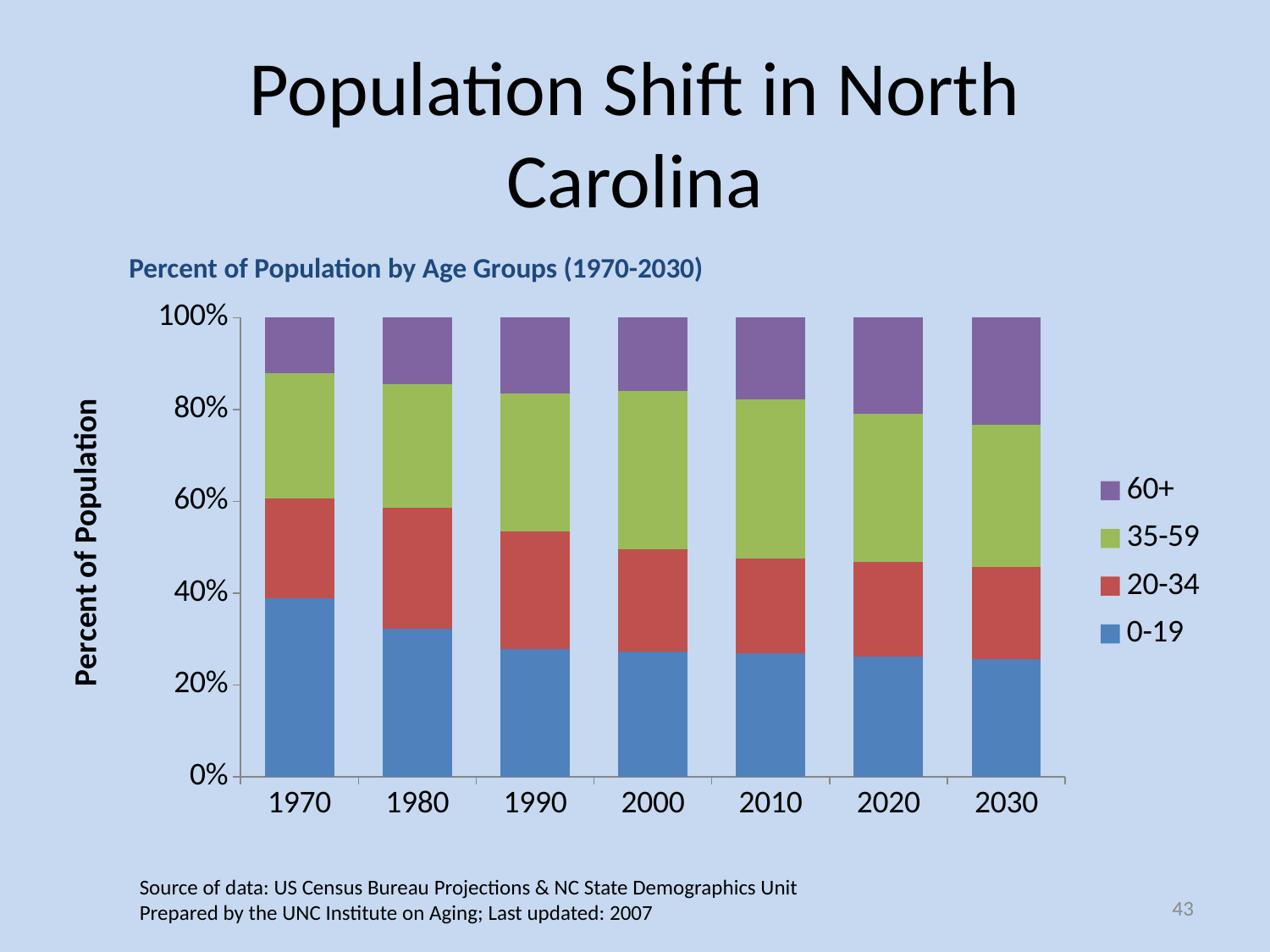
What is the label on the vertical axis of the chart? Percent of Population Is the share of the 0-19 age group in 2030 greater or less than 40%? less How many age groups does the legend list? 4 What kind of chart is shown on the slide? Stacked bar chart Does the share of the 0-19 age group rise or fall from 1970 to 2030? fall How many years are shown along the x axis of the chart? 7 Which year has the larger share for the 0-19 age group, 1970 or 2030? 1970 Is the share of the 0-19 age group in 1970 greater or less than 20%? greater What is the title of the chart? Percent of Population by Age Groups (1970-2030) Does the share of the 60+ age group rise or fall from 1970 to 2030? rise Which year has the larger share for the 60+ age group, 1970 or 2030? 2030 What is the total height of the stacked bar for 1970? 100%